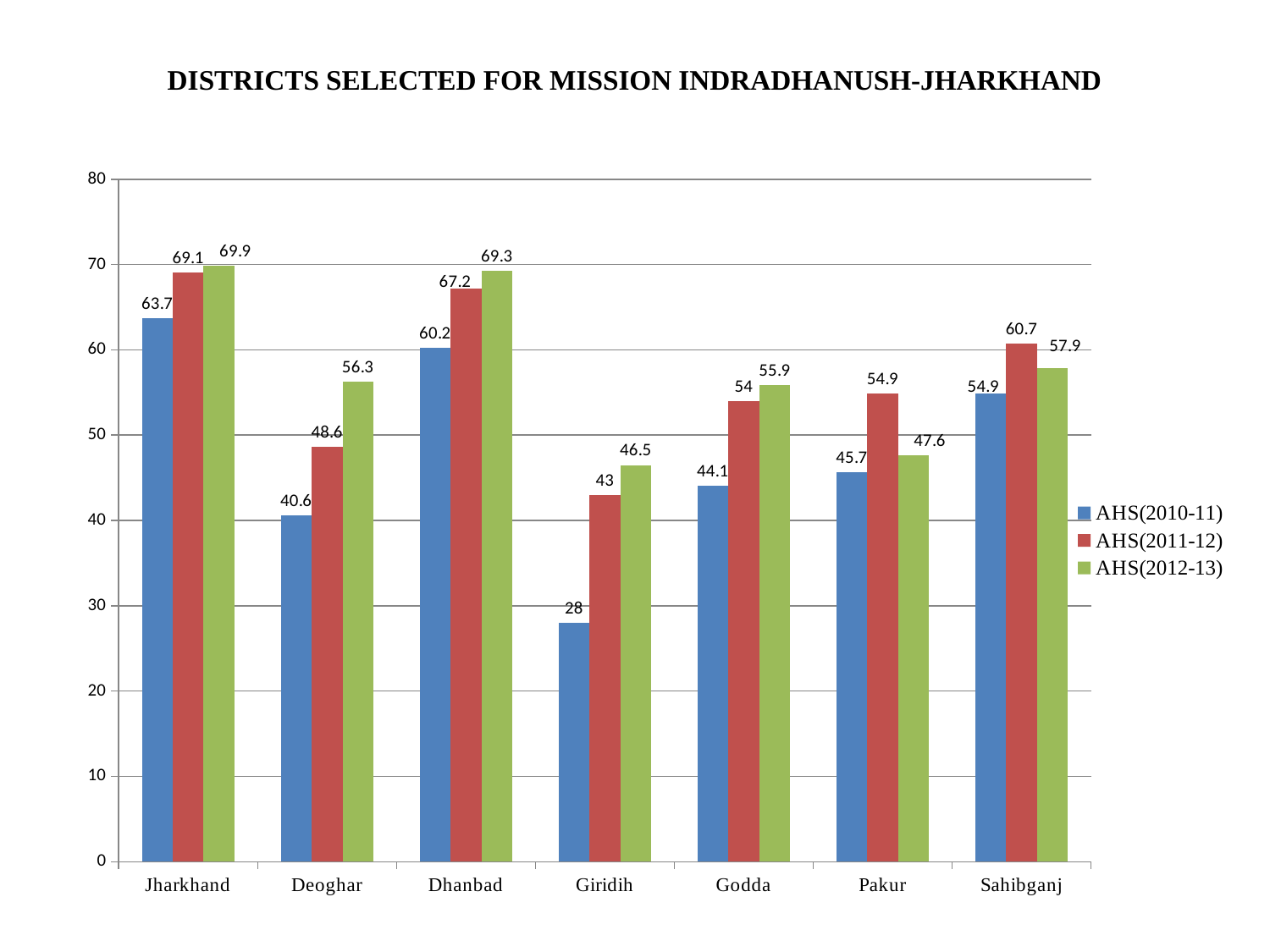
What is the AHS(2012-13) value for Deoghar? 56.3 Which is larger for Pakur: the AHS(2011-12) value or the AHS(2012-13) value? AHS(2011-12) What kind of chart is shown on the slide? Bar chart How many series does the legend list? 3 Is the AHS(2011-12) value for Godda greater or less than 50? greater Which category has the lowest AHS(2010-11) value? Giridih What is the AHS(2011-12) value for Sahibganj? 60.7 What is the AHS(2010-11) value for Giridih? 28 What is the difference between the AHS(2012-13) and AHS(2010-11) values for Giridih? 18.5 How many districts/categories are shown on the x axis? 7 Do the values for Dhanbad rise or fall from AHS(2010-11) to AHS(2012-13)? Rise Which category has the highest AHS(2012-13) value? Jharkhand